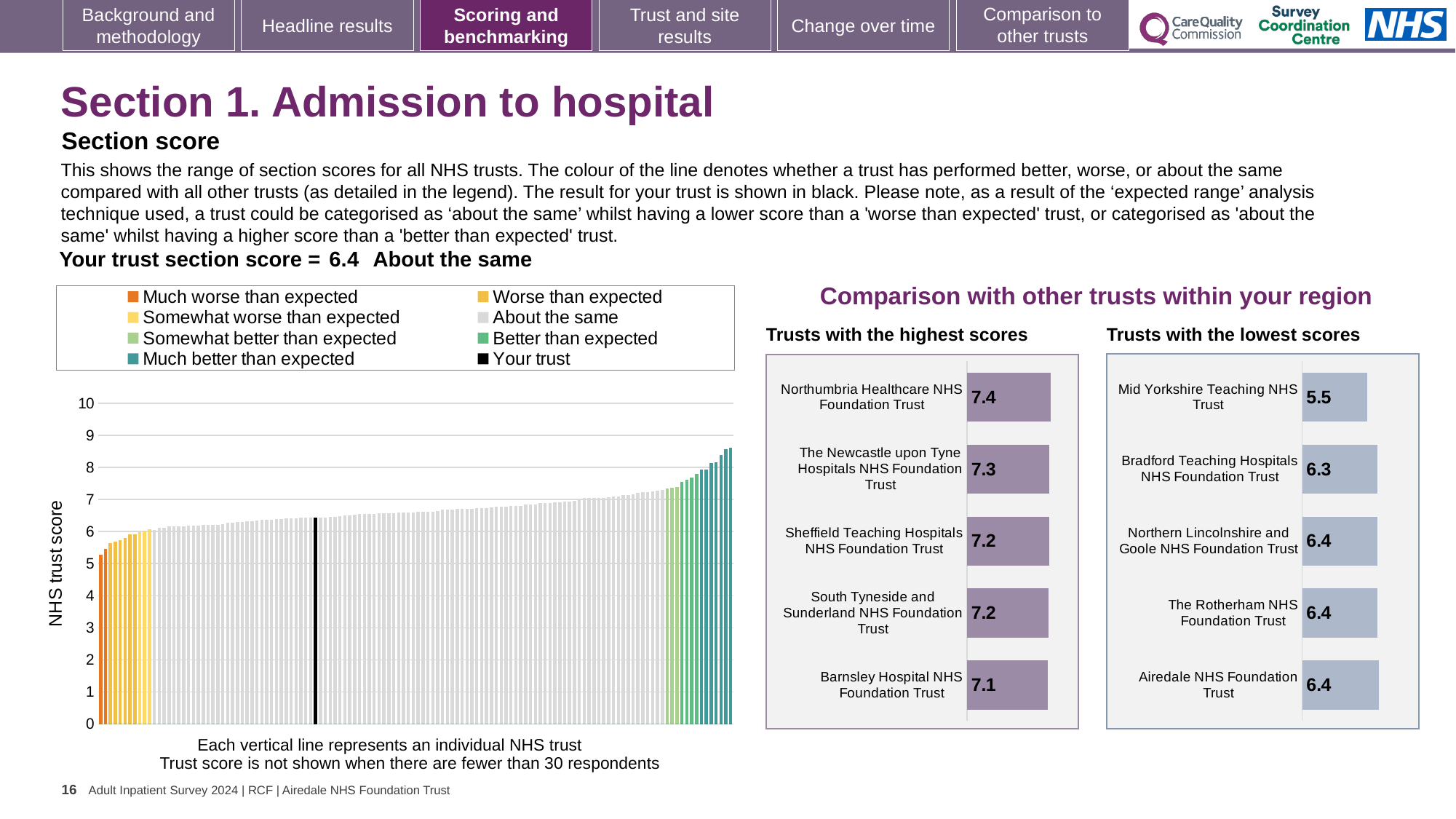
In the 'NHS trust score' chart on the left, do the bars rise or fall from left to right? rise In the 'Trusts with the highest scores' chart, which trust has the highest score? Northumbria Healthcare NHS Foundation Trust How many trusts are listed in the 'Trusts with the lowest scores' chart? 5 In the 'Trusts with the lowest scores' chart, what is the score for Bradford Teaching Hospitals NHS Foundation Trust? 6.3 In the 'Trusts with the lowest scores' chart, what is the difference between the scores of Bradford Teaching Hospitals NHS Foundation Trust and Mid Yorkshire Teaching NHS Trust? 0.8 How many entries does the legend of the 'NHS trust score' chart on the left list? 8 In the 'Trusts with the highest scores' chart, what is the score for Barnsley Hospital NHS Foundation Trust? 7.1 In the 'Trusts with the highest scores' chart, what is the difference between the scores of Northumbria Healthcare NHS Foundation Trust and Barnsley Hospital NHS Foundation Trust? 0.3 Which is larger: the score for The Newcastle upon Tyne Hospitals NHS Foundation Trust in the highest scores chart, or the score for Airedale NHS Foundation Trust in the lowest scores chart? The Newcastle upon Tyne Hospitals NHS Foundation Trust In the 'Trusts with the lowest scores' chart, which trust has the lowest score? Mid Yorkshire Teaching NHS Trust In the 'Trusts with the lowest scores' chart, what is the score for Mid Yorkshire Teaching NHS Trust? 5.5 In the 'Trusts with the highest scores' chart, what is the score for Northumbria Healthcare NHS Foundation Trust? 7.4